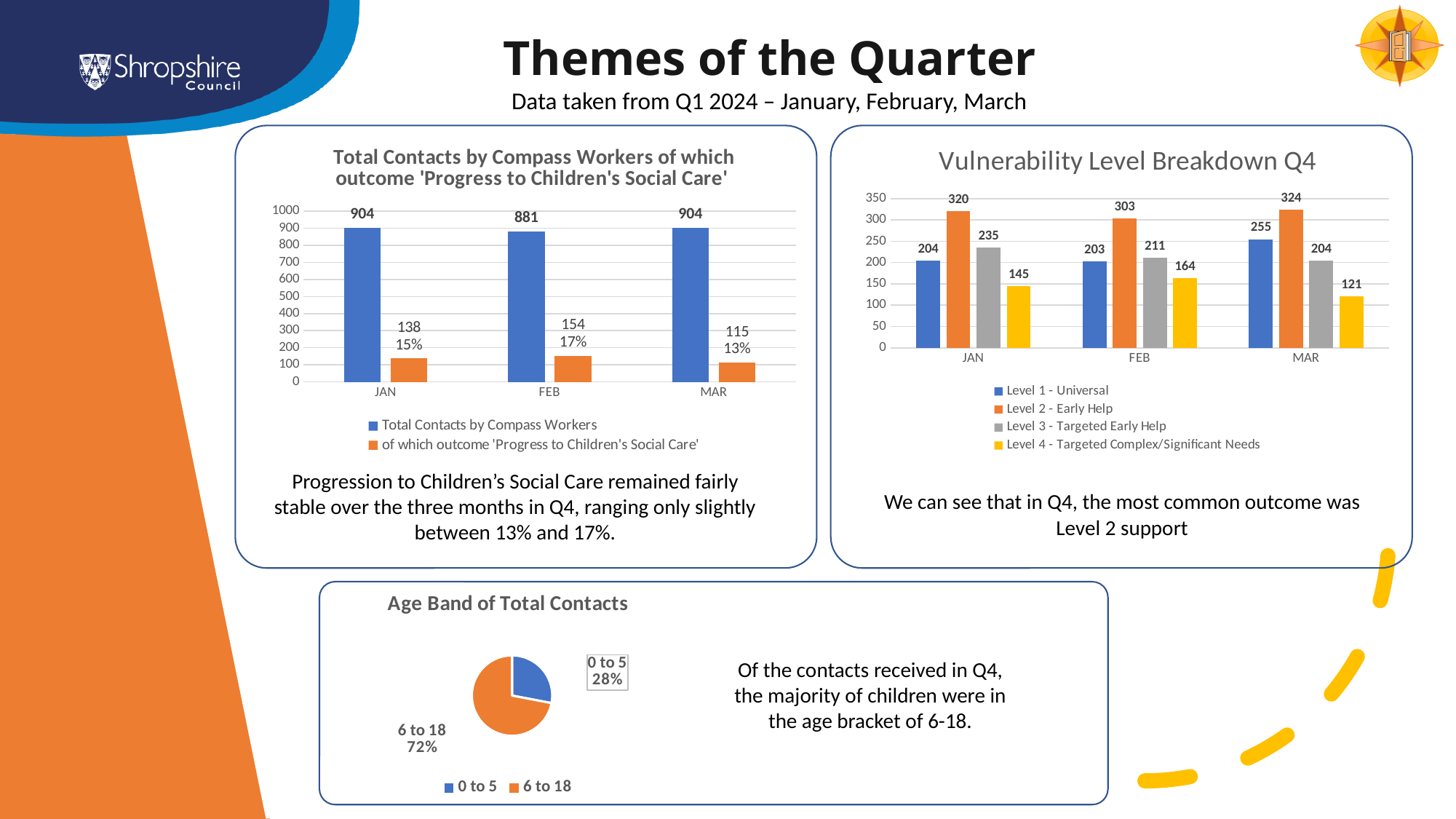
How many series does the legend of the 'Vulnerability Level Breakdown Q4' chart list? 4 In the 'Vulnerability Level Breakdown Q4' chart, what is the value for Level 3 - Targeted Early Help in JAN? 235 In the 'Total Contacts by Compass Workers' chart, what is the difference between Total Contacts by Compass Workers and the 'Progress to Children's Social Care' outcome in JAN? 766 In the 'Vulnerability Level Breakdown Q4' chart, which is larger in FEB: Level 1 - Universal or Level 3 - Targeted Early Help? Level 3 - Targeted Early Help What kind of chart is 'Age Band of Total Contacts'? Pie chart In the 'Age Band of Total Contacts' chart, what share of contacts is in the 6 to 18 age band? 72% In the 'Total Contacts by Compass Workers' chart, what percentage is shown for the 'Progress to Children's Social Care' outcome in FEB? 17% In the 'Total Contacts by Compass Workers' chart, which month has the lowest value for 'of which outcome Progress to Children's Social Care'? MAR In the 'Total Contacts by Compass Workers' chart, what is the value for 'of which outcome Progress to Children's Social Care' in MAR? 115 In the 'Vulnerability Level Breakdown Q4' chart, which month has the highest value for Level 2 - Early Help? MAR In the 'Vulnerability Level Breakdown Q4' chart, what is the difference between Level 4 values in JAN and MAR? 24 In the 'Total Contacts by Compass Workers' chart, what is the value of Total Contacts by Compass Workers for FEB? 881